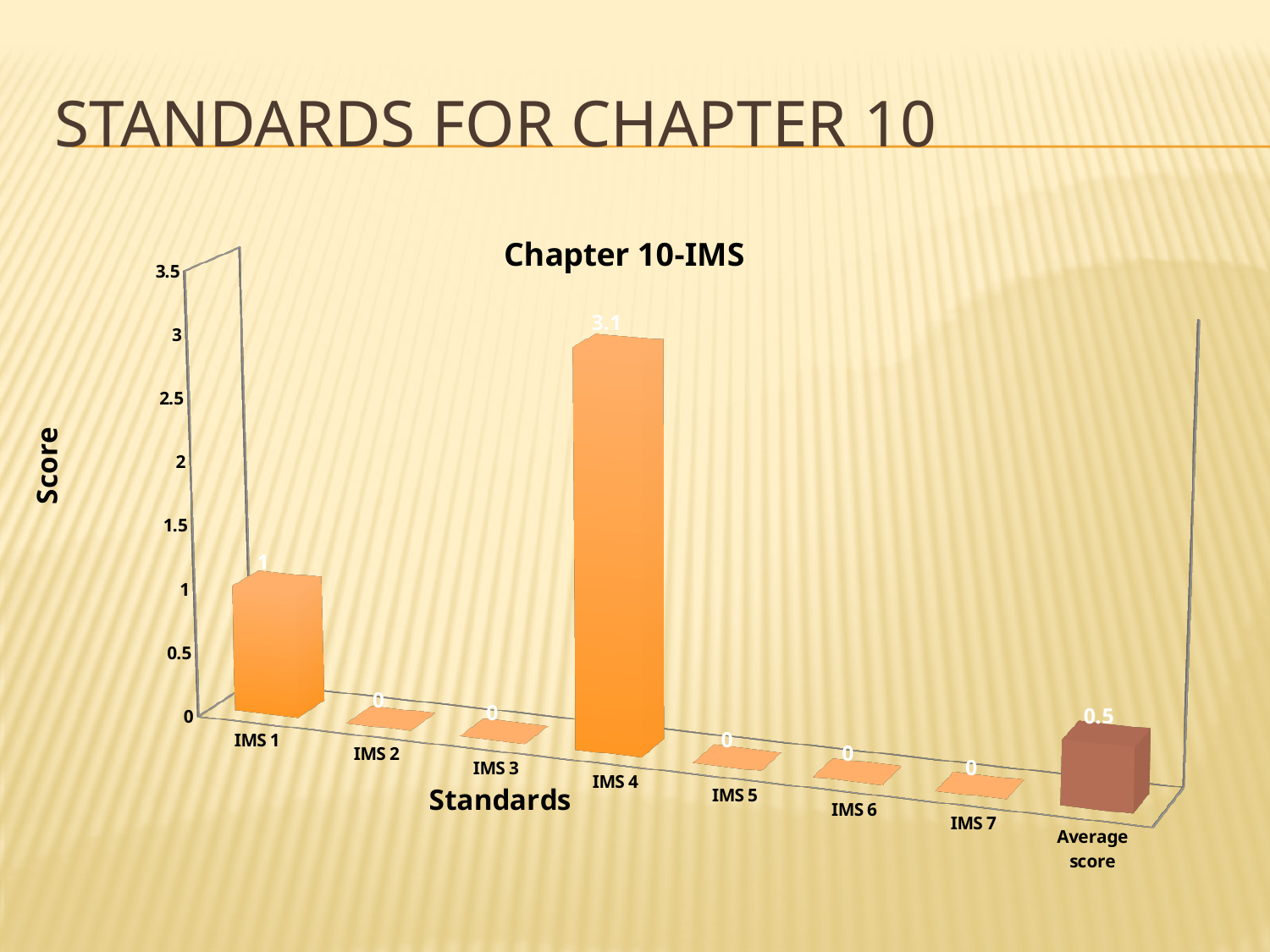
What is the Average score shown in the chart? 0.5 Which is larger, the score for IMS 1 or the Average score? IMS 1 What is the difference between the scores for IMS 4 and IMS 1? 2.1 Is the score for IMS 4 greater or less than 3? greater What kind of chart is shown on the slide? Bar chart How many categories are shown on the x axis of the chart? 8 What is the score for IMS 1? 1 How many standards have a score of 0? 5 What is the title of the chart? Chapter 10-IMS Which standard has the highest score? IMS 4 What is the score for IMS 4? 3.1 What is the score for IMS 5? 0